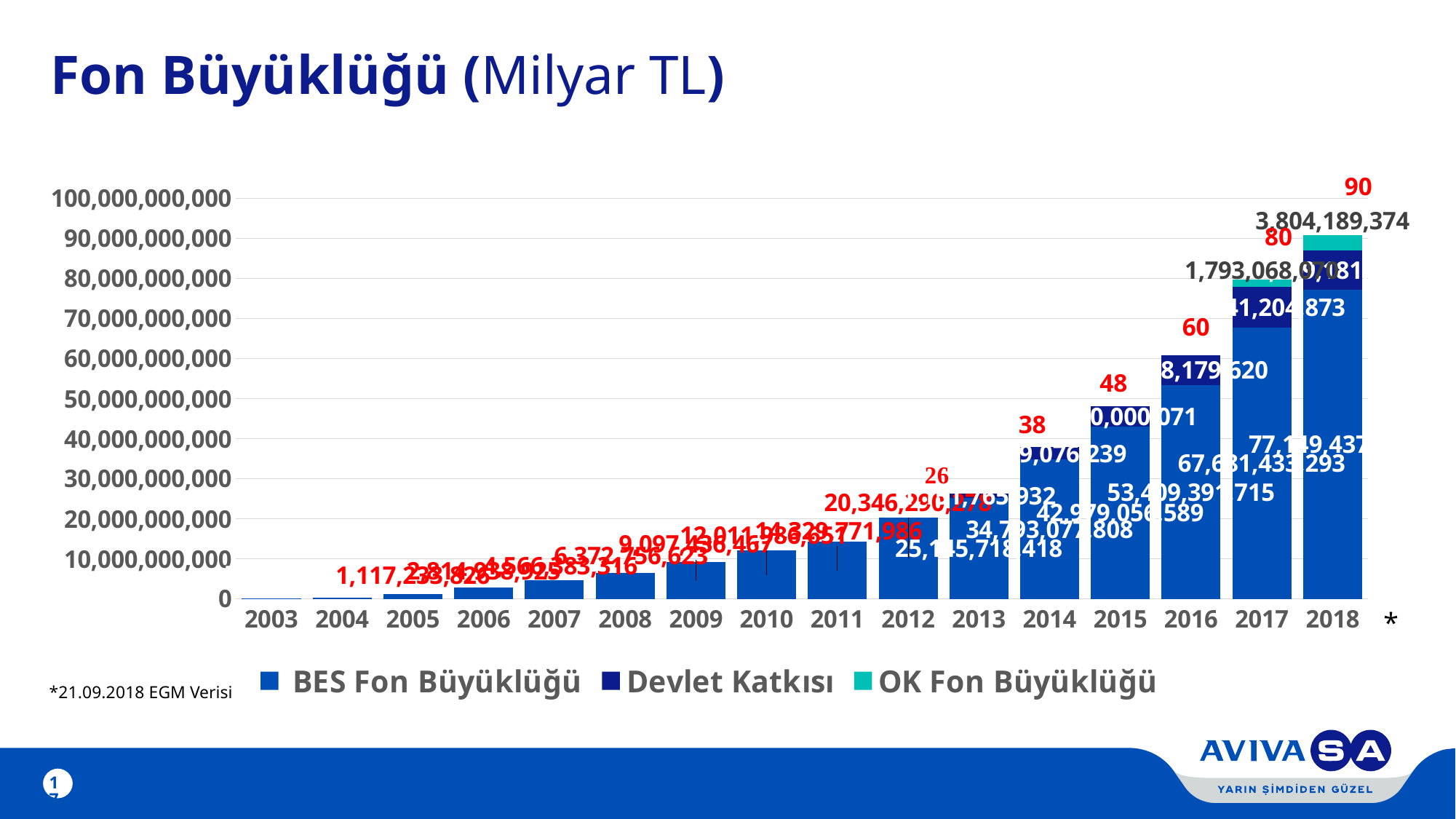
What red number is printed above the 2016 bar? 60 Do the stacked bar totals rise or fall from 2003 to 2018? rise Is the total stacked bar for 2014 greater or less than 30,000,000,000? greater Which year has the shortest stacked bar? 2003 Is the total stacked bar for 2018 greater or less than 80,000,000,000? greater What is the data label for OK Fon Büyüklüğü in 2018? 3,804,189,374 What type of chart is shown on the slide? bar chart What red number is printed above the 2018 bar? 90 Which year has the larger stacked bar, 2015 or 2017? 2017 Which year has the tallest stacked bar? 2018 How many years are shown on the x axis? 16 How many series does the legend list? 3